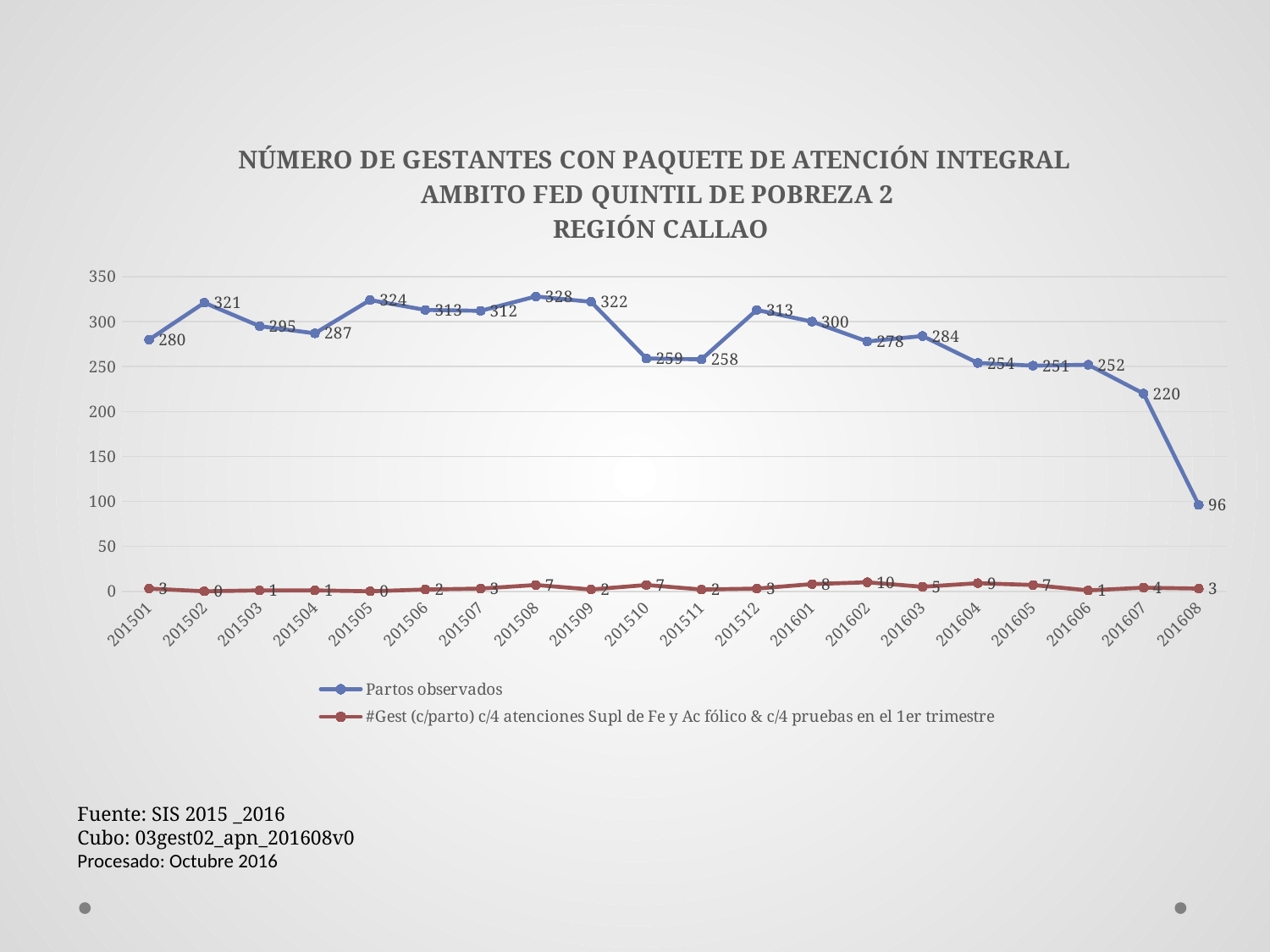
How many series does the legend list? 2 What is the difference between Partos observados in 201607 and 201608? 124 Which region does the chart title refer to? Región Callao What is the value of Partos observados for 201608? 96 In which period is Partos observados highest? 201508 Which is larger, Partos observados in 201502 or in 201505? 201505 In which period does the #Gest (c/parto) series reach its highest value? 201602 What type of chart is shown on the slide? Line chart In which period is Partos observados lowest? 201608 What is the value of Partos observados for 201508? 328 How many time periods are plotted along the x axis? 20 What is the value of the #Gest (c/parto) series for 201602? 10